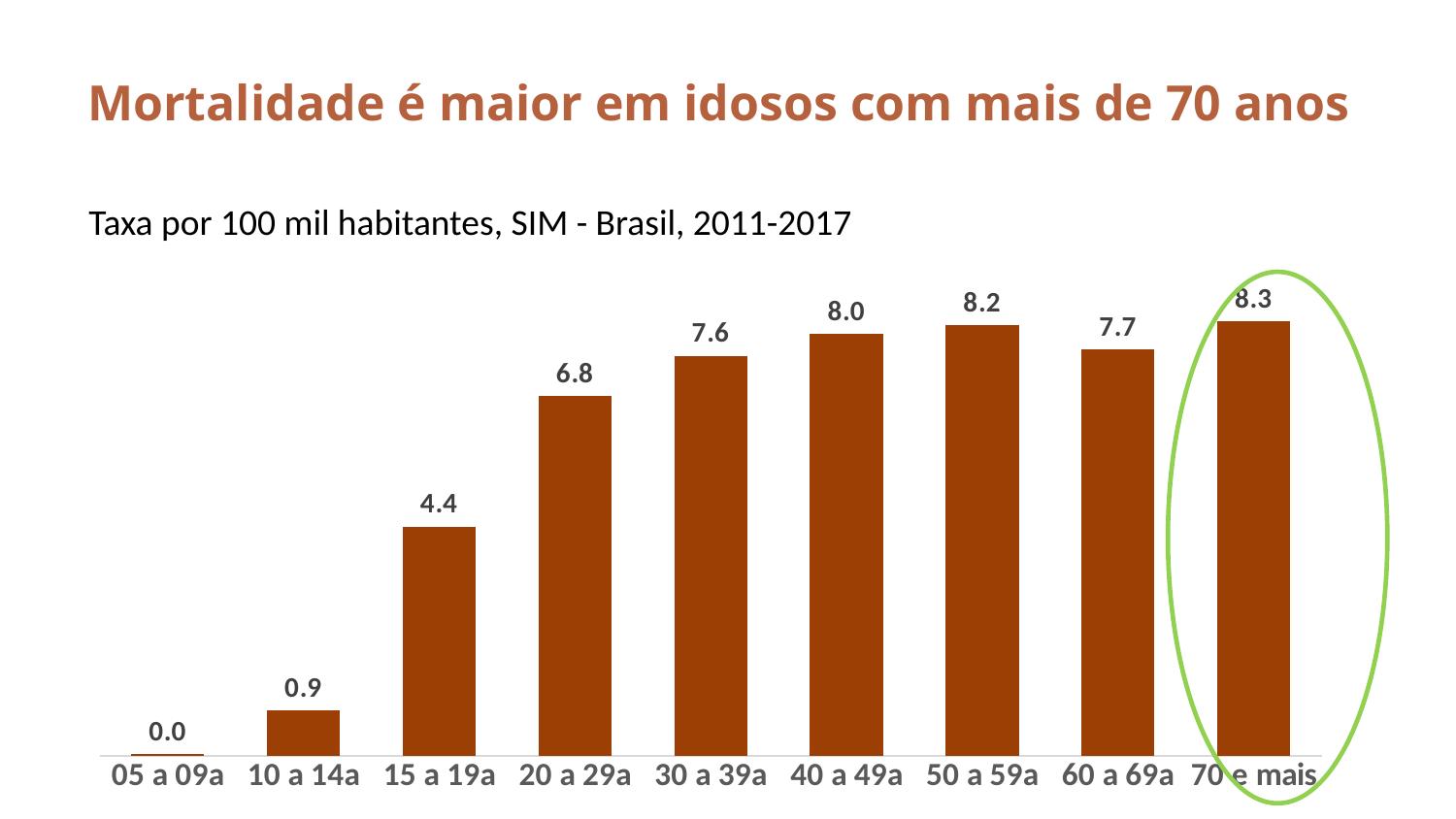
How many age groups are shown on the chart? 9 What is the value for the 10 a 14a age group? 0.9 What is the difference between the values for 30 a 39a and 15 a 19a? 3.2 Which age group has the highest value? 70 e mais Which is larger, the value for 60 a 69a or the value for 20 a 29a? 60 a 69a What is the difference between the values for 40 a 49a and 20 a 29a? 1.2 Which age group has the lowest value? 05 a 09a What kind of chart is shown on the slide? Bar chart What is the value for the 50 a 59a age group? 8.2 Which age group is circled in green on the chart? 70 e mais What is the value for the 70 e mais age group? 8.3 What is the value for the 15 a 19a age group? 4.4